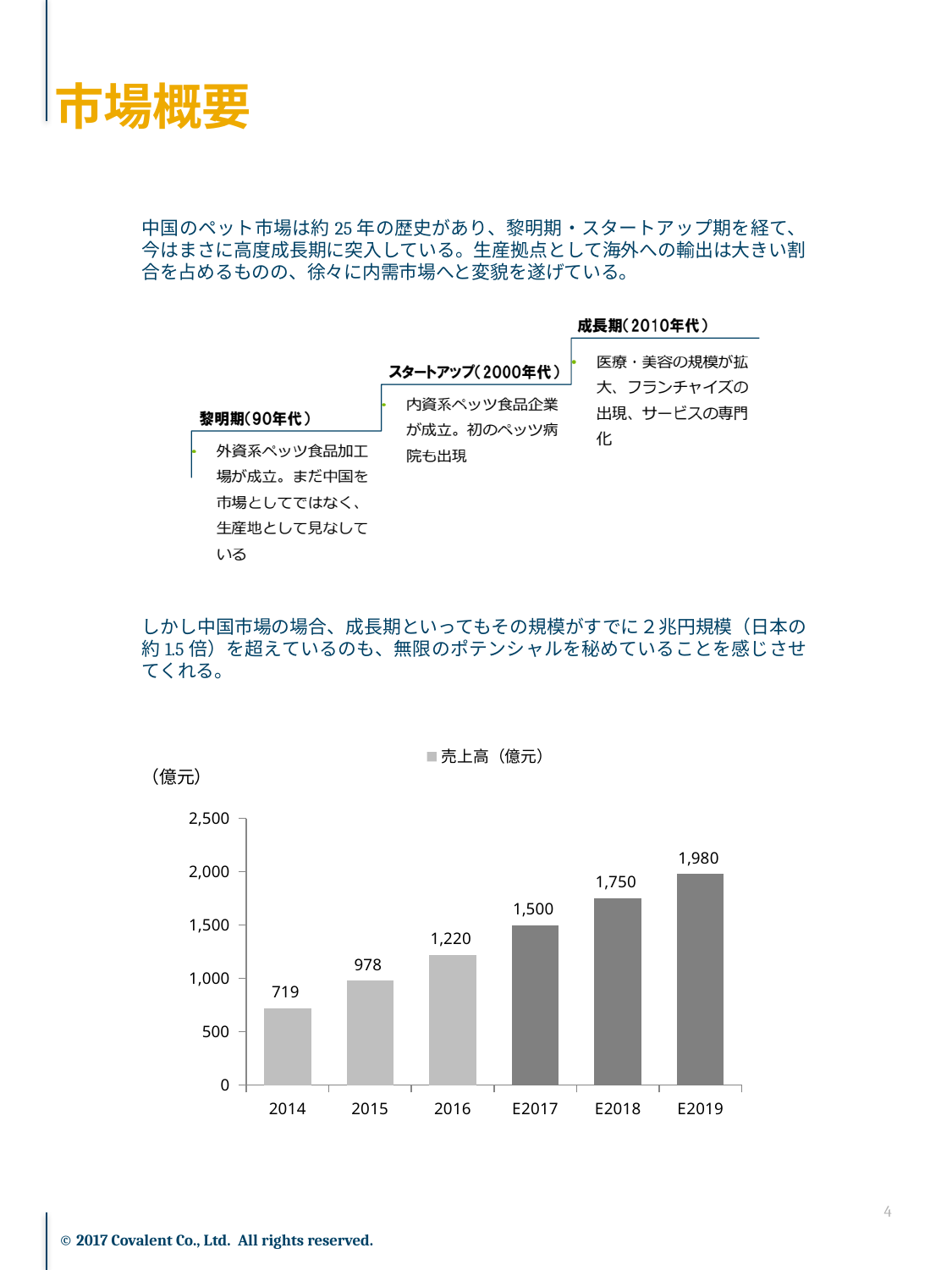
What is the value for E2018 in the bar chart? 1,750 What is the difference between the values for 2015 and 2014? 259 Is the value for 2015 greater or less than 1,000? less What is the difference between the values for E2019 and E2017? 480 Which year has the highest value in the bar chart? E2019 How many bars are shown in the bar chart? 6 What kind of chart is shown on the slide? bar chart What is the value for 2016 in the bar chart? 1,220 Which year has the lowest value in the bar chart? 2014 Do the values rise or fall from 2014 to E2019? rise Which is larger, the value for 2016 or the value for E2017? E2017 What is the value for 2014 in the bar chart? 719